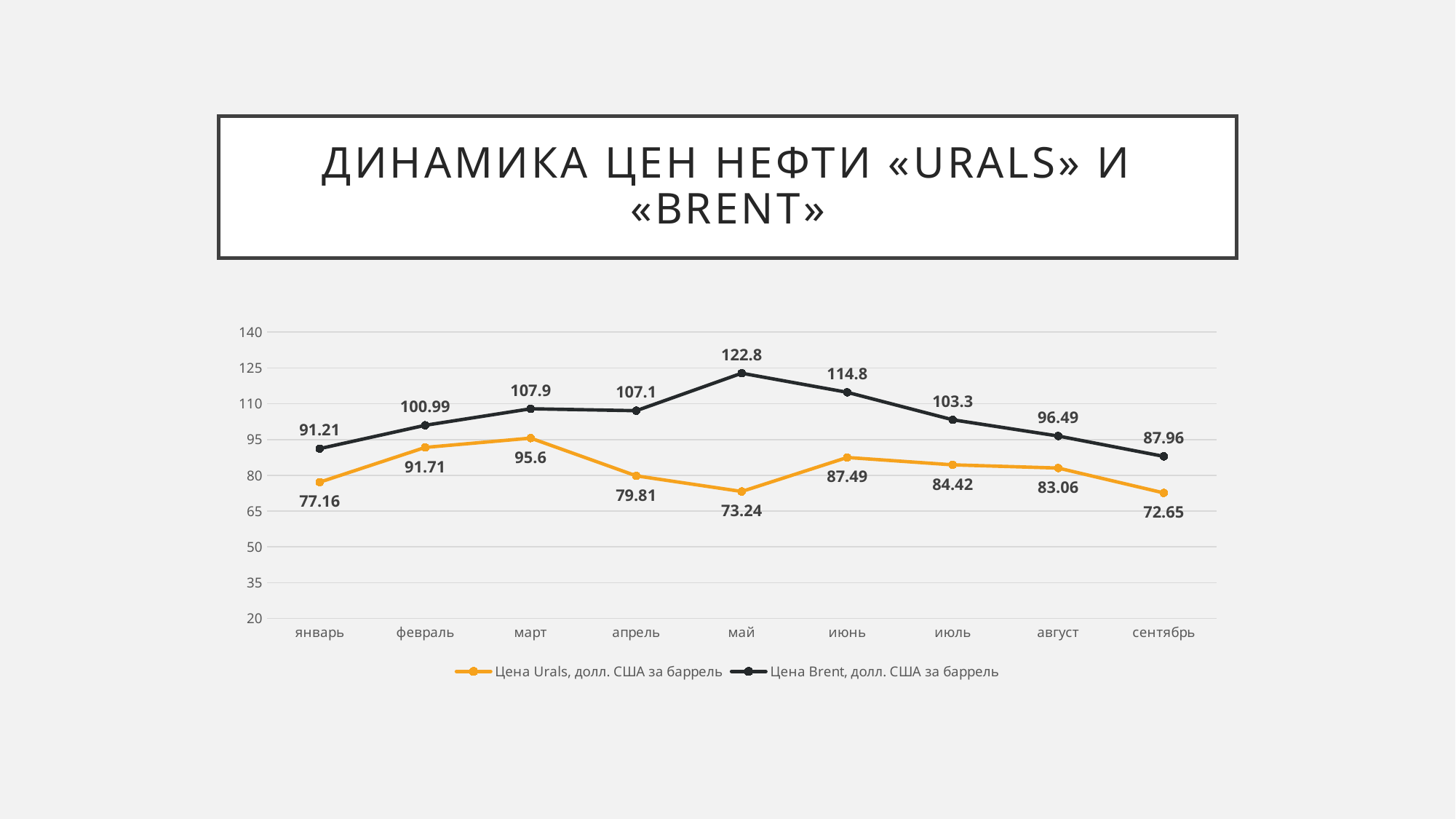
What is the Urals price in March (март)? 95.6 What kind of chart is shown on the slide? Line chart In which month is the Brent price highest? май How many months are shown on the x axis? 9 Which colour is used for the Urals price line? Orange Does the Brent price rise or fall from May (май) to September (сентябрь)? Fall In which month is the Urals price lowest? сентябрь What is the Brent price in May (май)? 122.8 Which is larger: the Urals price in February (февраль) or the Urals price in June (июнь)? February (февраль), 91.71 How many series does the legend list? 2 What is the Urals price in September (сентябрь)? 72.65 What is the difference between the Brent and Urals prices in May (май)? 49.56